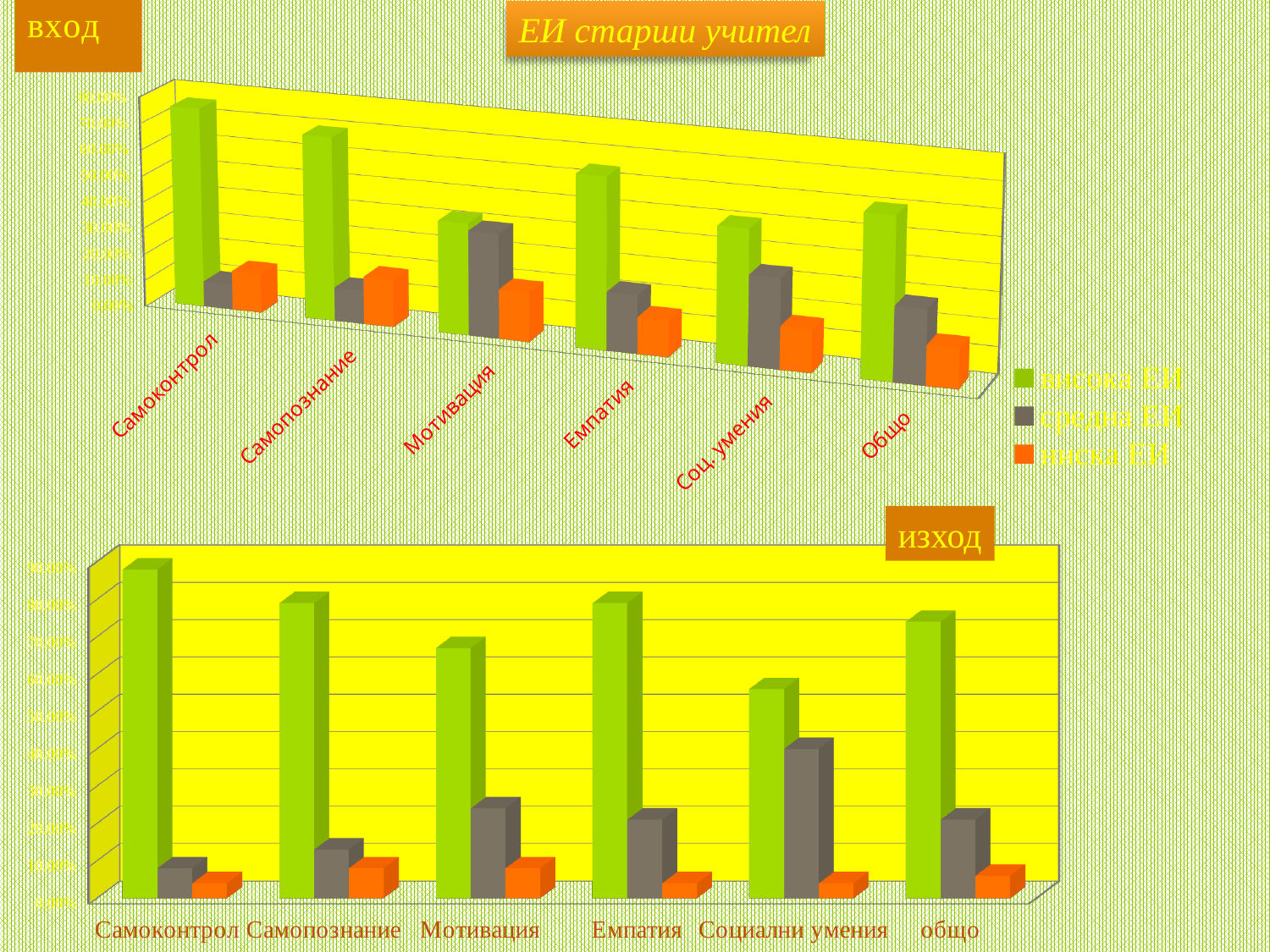
In the bottom chart (изход), which category has the highest value for the висока ЕИ series? Самоконтрол How many categories are shown on the x axis of the top chart (вход)? 6 How many series does the legend list? 3 What is the title shown at the top of the slide? ЕИ старши учител In the top chart (вход), which category has the highest value for the висока ЕИ series? Самоконтрол In the bottom chart (изход), for Социални умения, which is larger: средна ЕИ or ниска ЕИ? средна ЕИ How many categories are shown on the x axis of the bottom chart (изход)? 6 What kind of chart is the top chart (вход)? bar chart What kind of chart is the bottom chart (изход)? bar chart In the top chart (вход), which category has the highest value for the средна ЕИ series? Мотивация In the bottom chart (изход), which category has the lowest value for the висока ЕИ series? Социални умения